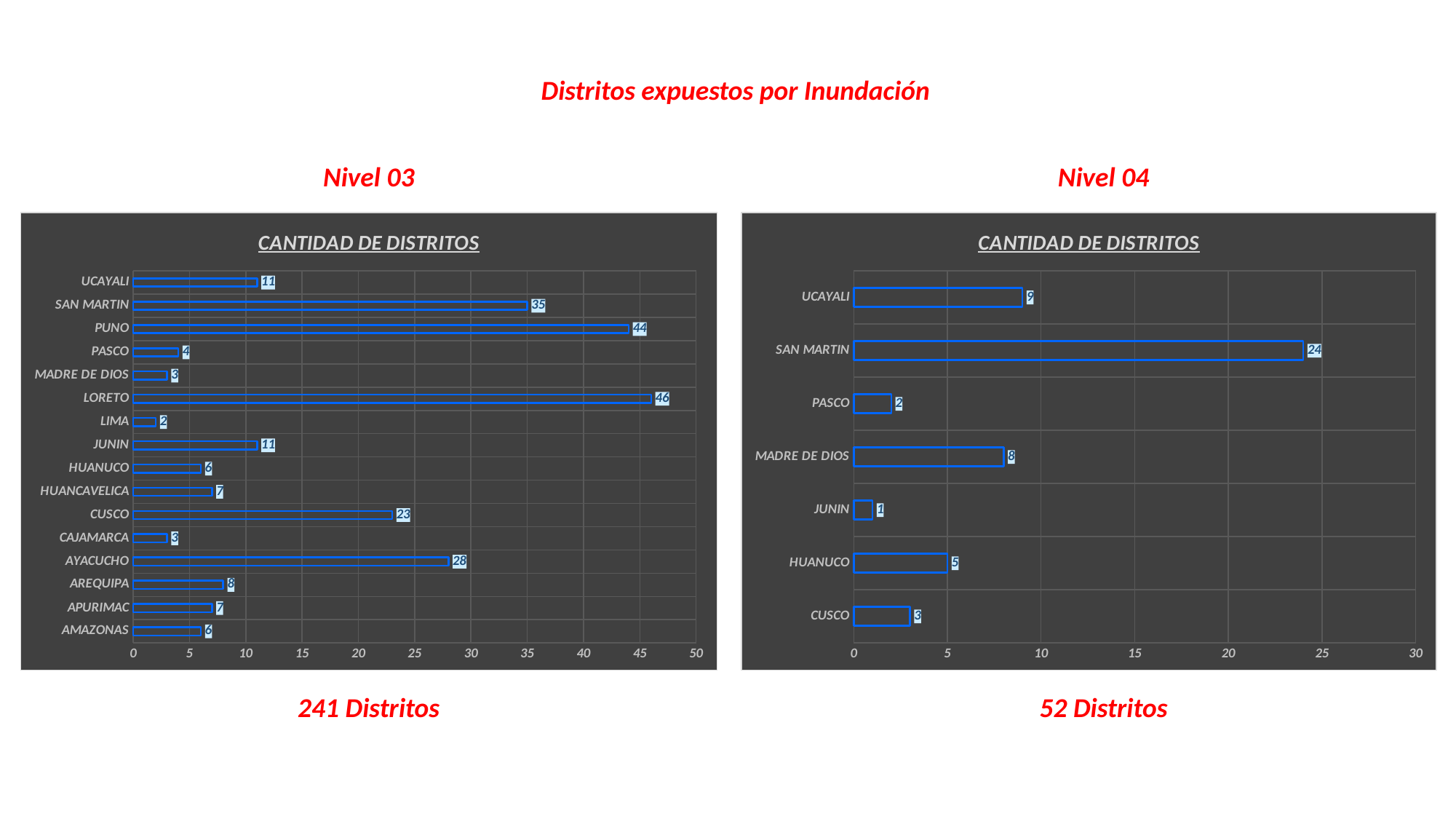
In the Nivel 04 chart on the right, what is the value for SAN MARTIN? 24 In the Nivel 04 chart on the right, which is larger, the value for UCAYALI or the value for MADRE DE DIOS? UCAYALI How many categories are shown in the Nivel 04 chart on the right? 7 In the Nivel 03 chart on the left, what is the value for CUSCO? 23 How many categories are shown in the Nivel 03 chart on the left? 16 In the Nivel 03 chart on the left, is the value for AYACUCHO greater or less than 25? greater In the Nivel 03 chart on the left, which category has the highest value? LORETO What is the title shown inside the Nivel 04 chart on the right? CANTIDAD DE DISTRITOS In the Nivel 04 chart on the right, which category has the lowest value? JUNIN In the Nivel 03 chart on the left, what is the value for LORETO? 46 What kind of chart is the Nivel 03 chart on the left? Bar chart In the Nivel 03 chart on the left, what is the difference between the values for PUNO and SAN MARTIN? 9